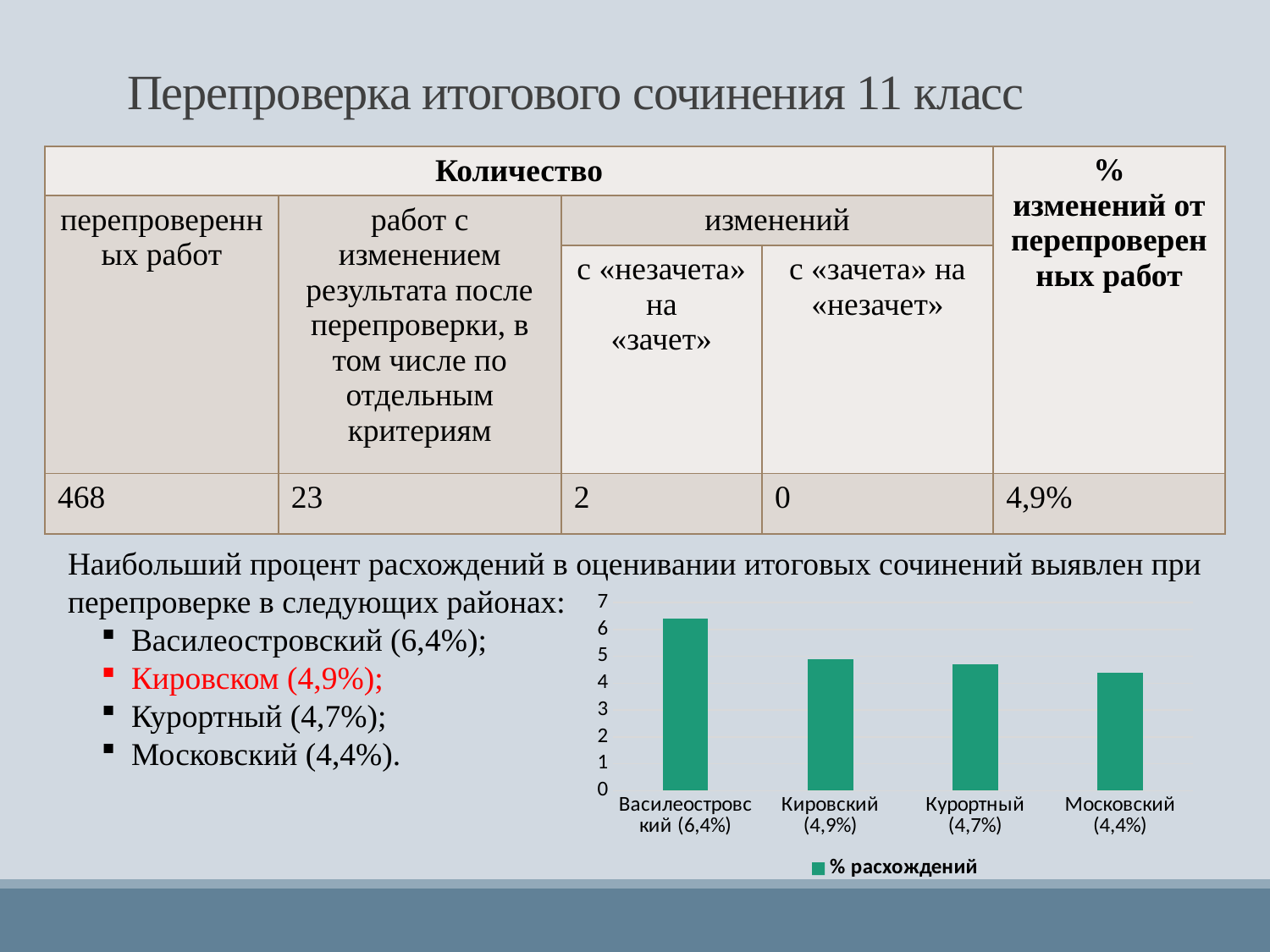
Do the values rise or fall from left to right along the x axis? fall What is the value for Московский in the chart? 4,4% What is the value for Кировский in the chart? 4,9% What is the difference between the values for Василеостровский and Кировский? 1,5% What is the value for Курортный in the chart? 4,7% Which district has the lowest value in the chart? Московский What is the legend entry of the chart? % расхождений How many series does the chart legend list? 1 What is the value for Василеостровский in the chart? 6,4% Which district has the highest value in the chart? Василеостровский What type of chart is shown on the slide? bar chart How many districts (bars) are shown in the chart? 4